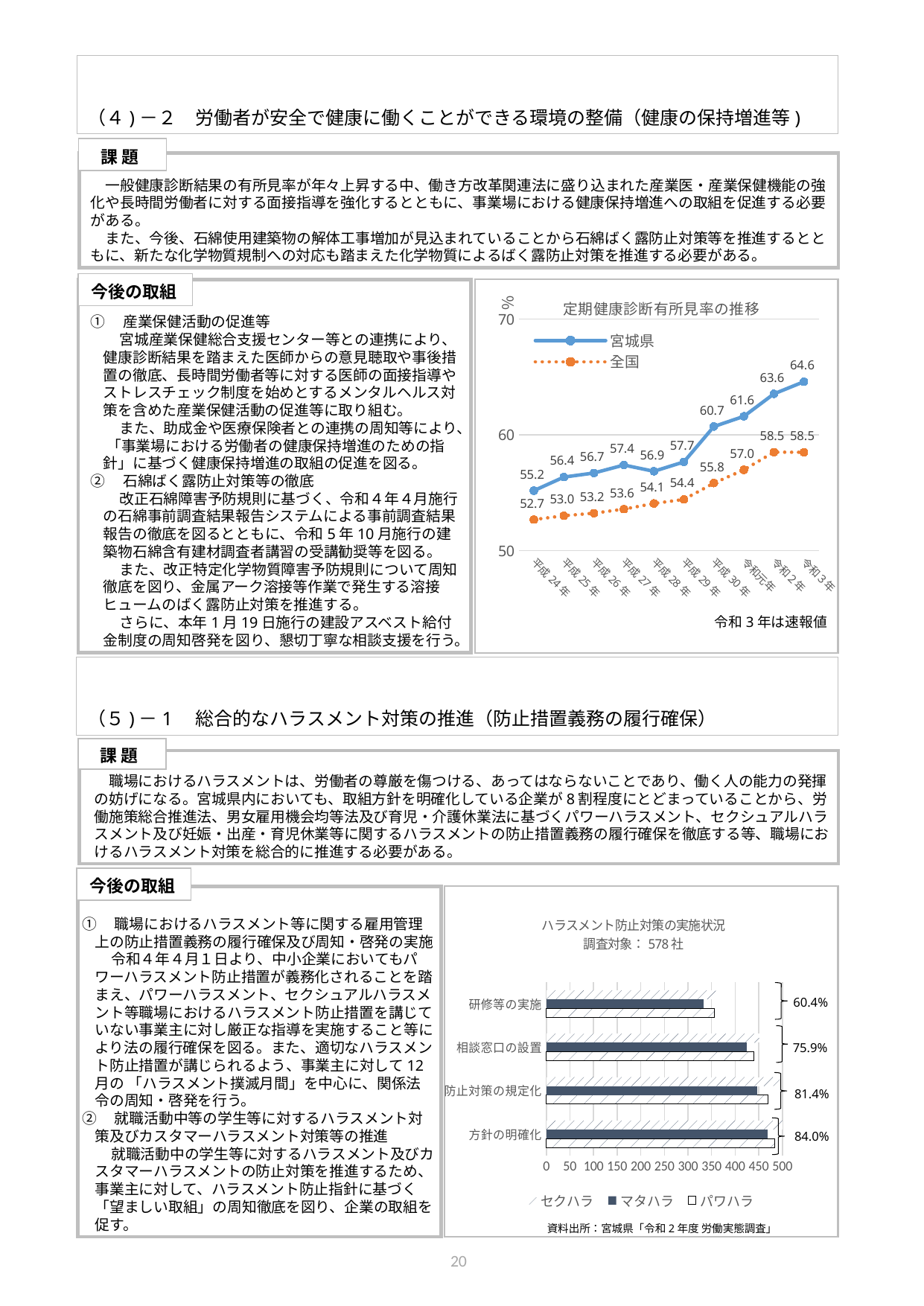
In the ハラスメント防止対策の実施状況 chart, is the マタハラ value for 研修等の実施 greater or less than 400? less What kind of chart is the 定期健康診断有所見率の推移 chart? line chart In the 定期健康診断有所見率の推移 chart, what is the value for 全国 in 平成24年? 52.7 How many years are plotted in the 定期健康診断有所見率の推移 chart? 10 How many series does the legend of the ハラスメント防止対策の実施状況 chart list? 3 In the 定期健康診断有所見率の推移 chart, which is larger in 平成29年, 宮城県 or 全国? 宮城県 How many series does the legend of the 定期健康診断有所見率の推移 chart list? 2 In the 定期健康診断有所見率の推移 chart, which year has the lowest value for 宮城県? 平成24年 In the 定期健康診断有所見率の推移 chart, does the 全国 series generally rise or fall from 平成24年 to 令和3年? rise In the 定期健康診断有所見率の推移 chart, what is the value for 宮城県 in 令和3年? 64.6 In the 定期健康診断有所見率の推移 chart, what is the difference between 宮城県 and 全国 in 令和3年? 6.1 What kind of chart is the ハラスメント防止対策の実施状況 chart? bar chart